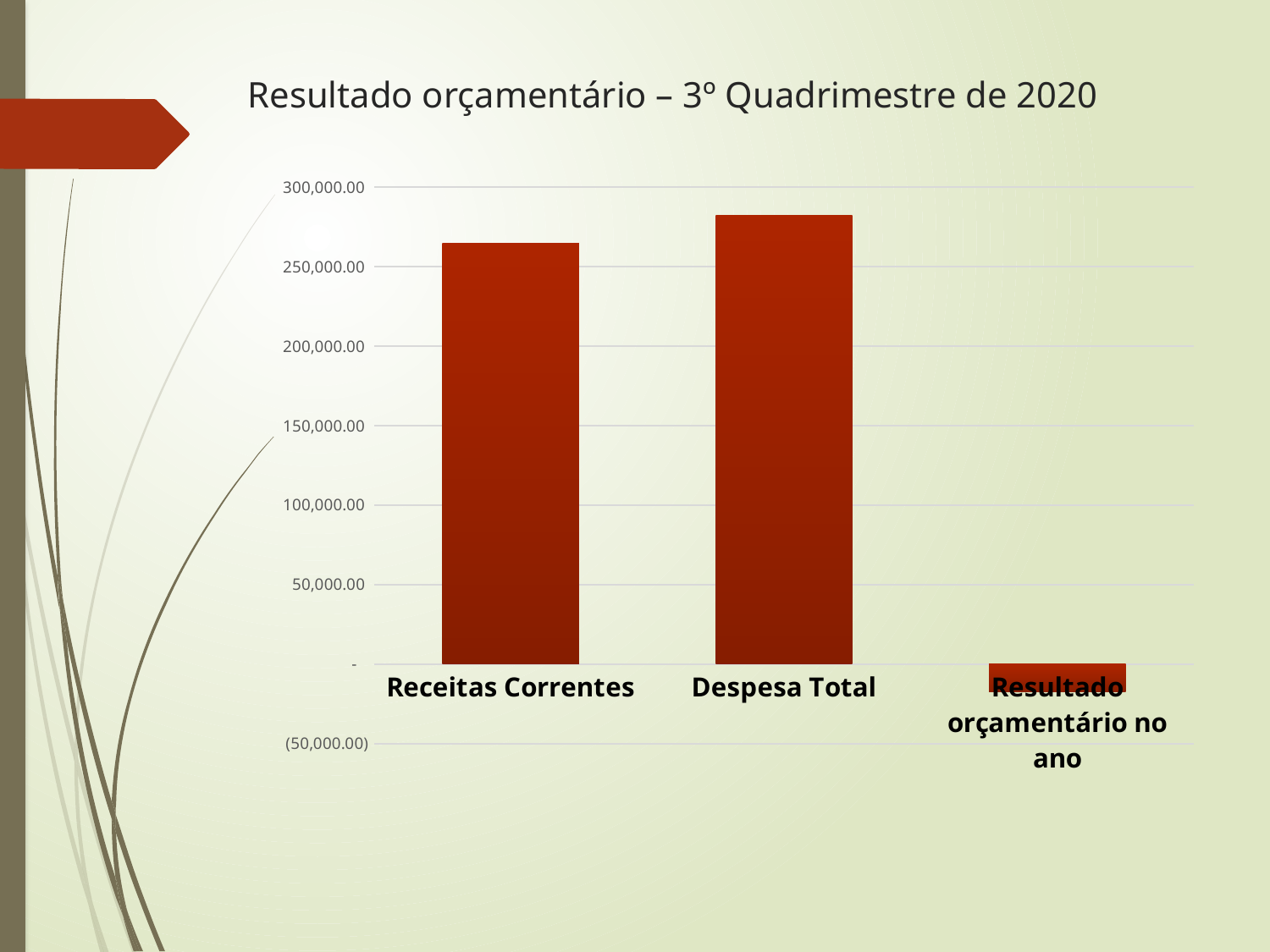
What is the title of the slide containing the chart? Resultado orçamentário – 3º Quadrimestre de 2020 What is the highest value shown on the vertical axis? 300,000.00 Which is larger, Receitas Correntes or Despesa Total? Despesa Total What kind of chart is shown on the slide? bar chart Is the value for Receitas Correntes greater or less than 250,000.00? greater Which category has the highest value? Despesa Total How many categories are plotted in the chart? 3 Which category has the lowest value? Resultado orçamentário no ano Is the value for Resultado orçamentário no ano greater or less than 0? less Is the value for Despesa Total greater or less than 250,000.00? greater